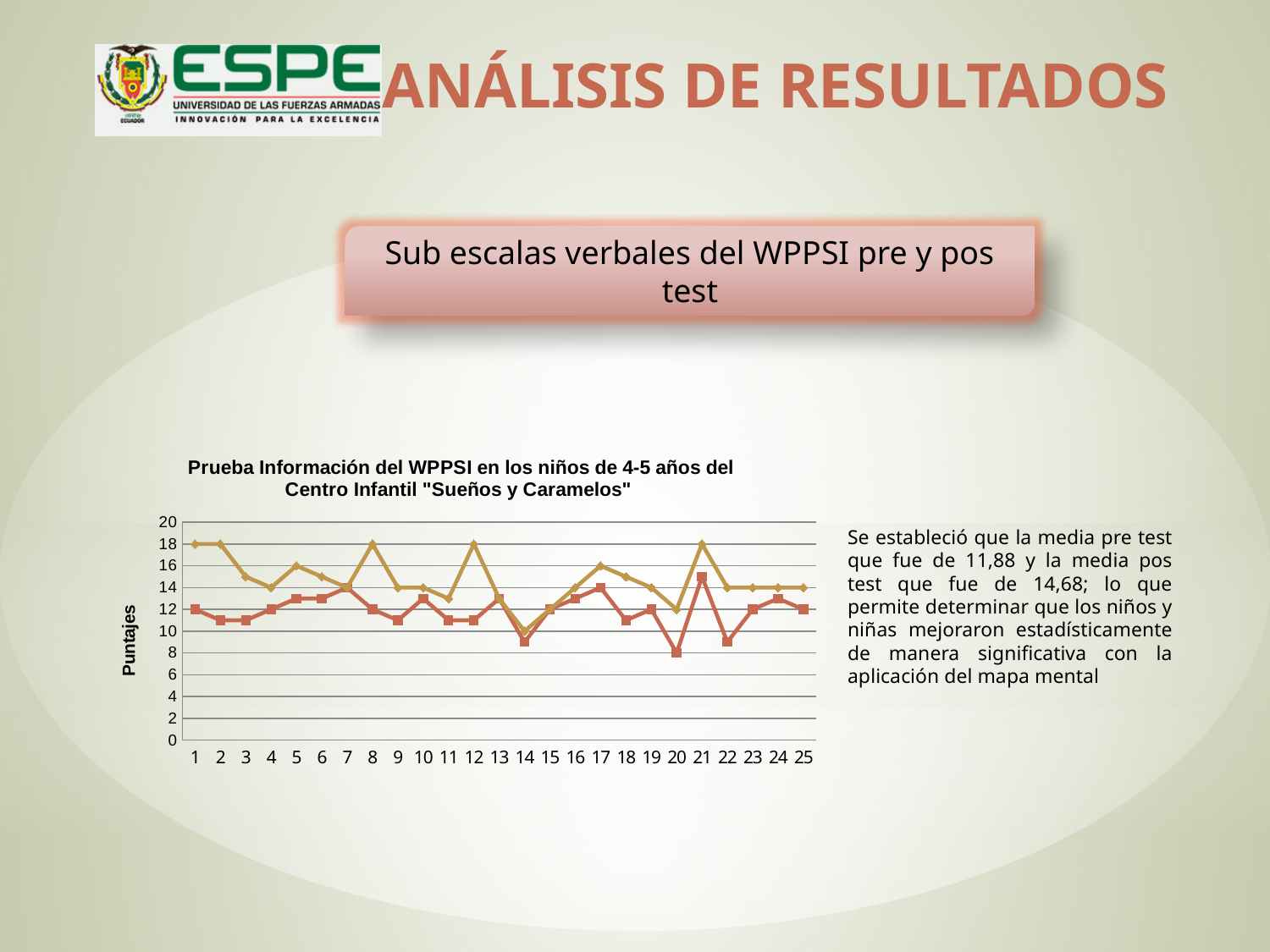
What is the value of the gold line with diamond markers at point 1? 18 What is the label of the vertical axis of the chart? Puntajes What is the value of the red line with square markers at point 1? 12 Is the value of the red line at point 14 greater or less than 10? less What is the title of the chart? Prueba Información del WPPSI en los niños de 4-5 años del Centro Infantil "Sueños y Caramelos" What kind of chart is shown on the slide? line chart What is the value of the gold line with diamond markers at point 21? 18 How many points are plotted along the x axis for each line? 25 At point 1, what is the difference between the gold line and the red line? 6 At which point does the red line with square markers reach its lowest value? 20 At point 1, which line has the larger value, the gold line or the red line? the gold line What is the value of the red line with square markers at point 20? 8